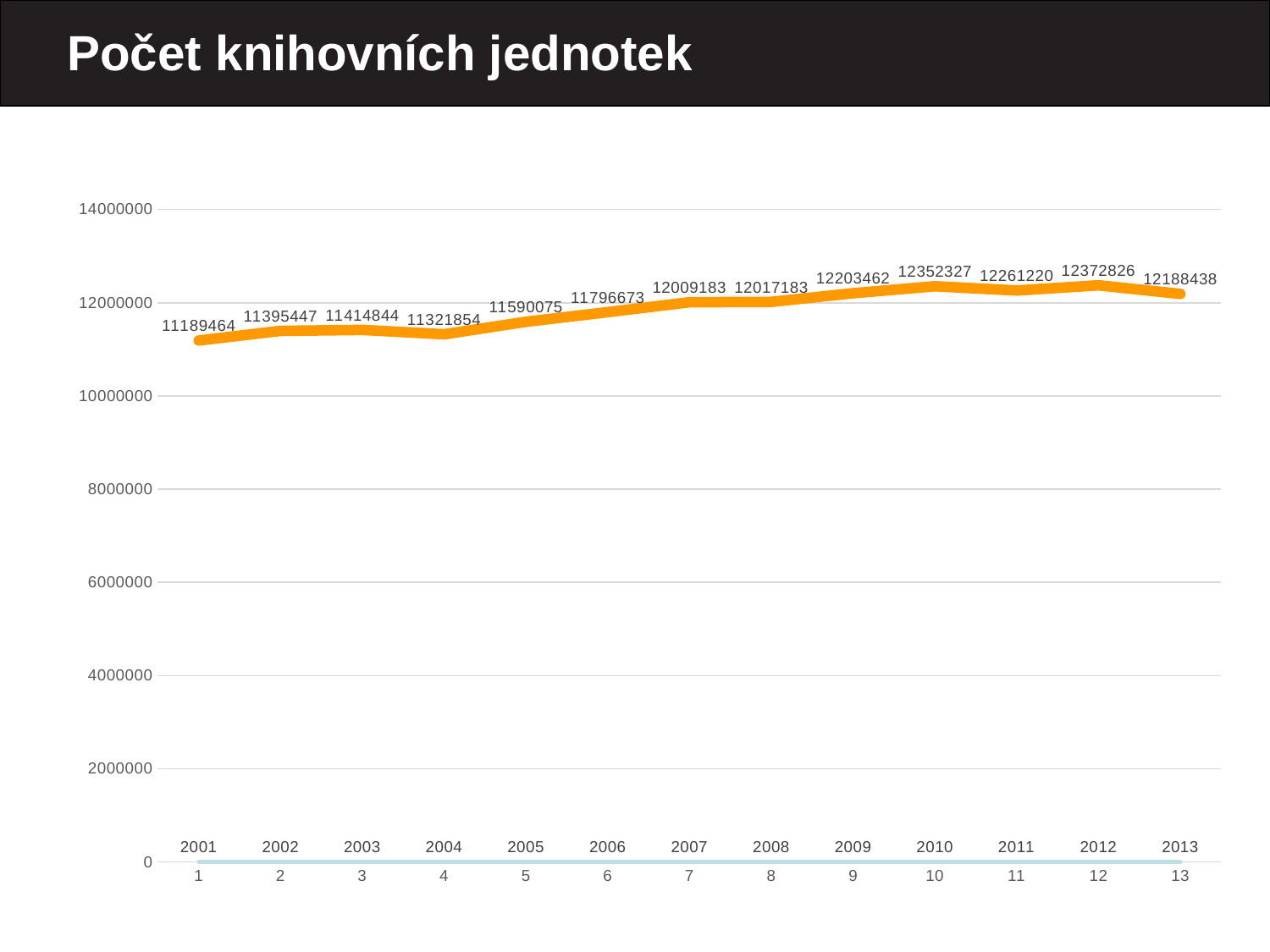
What is the title of the chart? Počet knihovních jednotek What kind of chart is shown? line chart What is the value for 2010? 12352327 What is the difference between the values for 2012 and 2011? 111606 How many years are plotted on the x axis? 13 What is the value for 2013? 12188438 What is the value for 2001? 11189464 Is the value for 2009 greater or less than 12000000? greater Which is larger, the value for 2004 or the value for 2005? 2005 What is the difference between the values for 2013 and 2001? 998974 Which year has the lowest value? 2001 Which year has the highest value? 2012